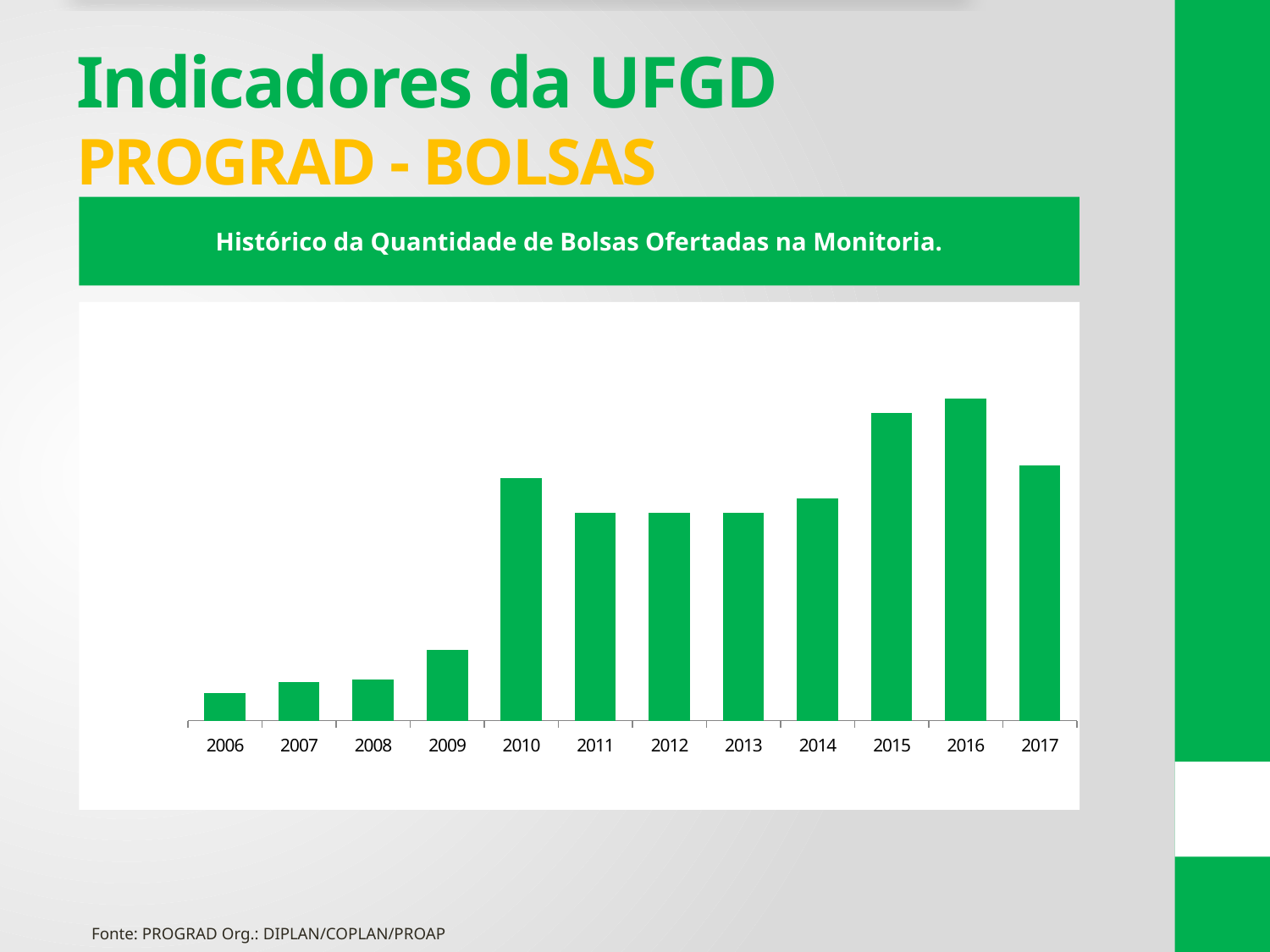
Which year has the higher bar, 2010 or 2011? 2010 Do the bars rise or fall from 2006 to 2010? rise Which year has the highest bar in the chart? 2016 How many years are shown on the x axis of the chart? 12 Which year has the lowest bar in the chart? 2006 Do the bars rise or fall from 2016 to 2017? fall Which year has the higher bar, 2016 or 2017? 2016 Which year has the higher bar, 2015 or 2017? 2015 What kind of chart is shown on the slide? bar chart What colour are the bars in the chart? green What is the title of the chart? Histórico da Quantidade de Bolsas Ofertadas na Monitoria.